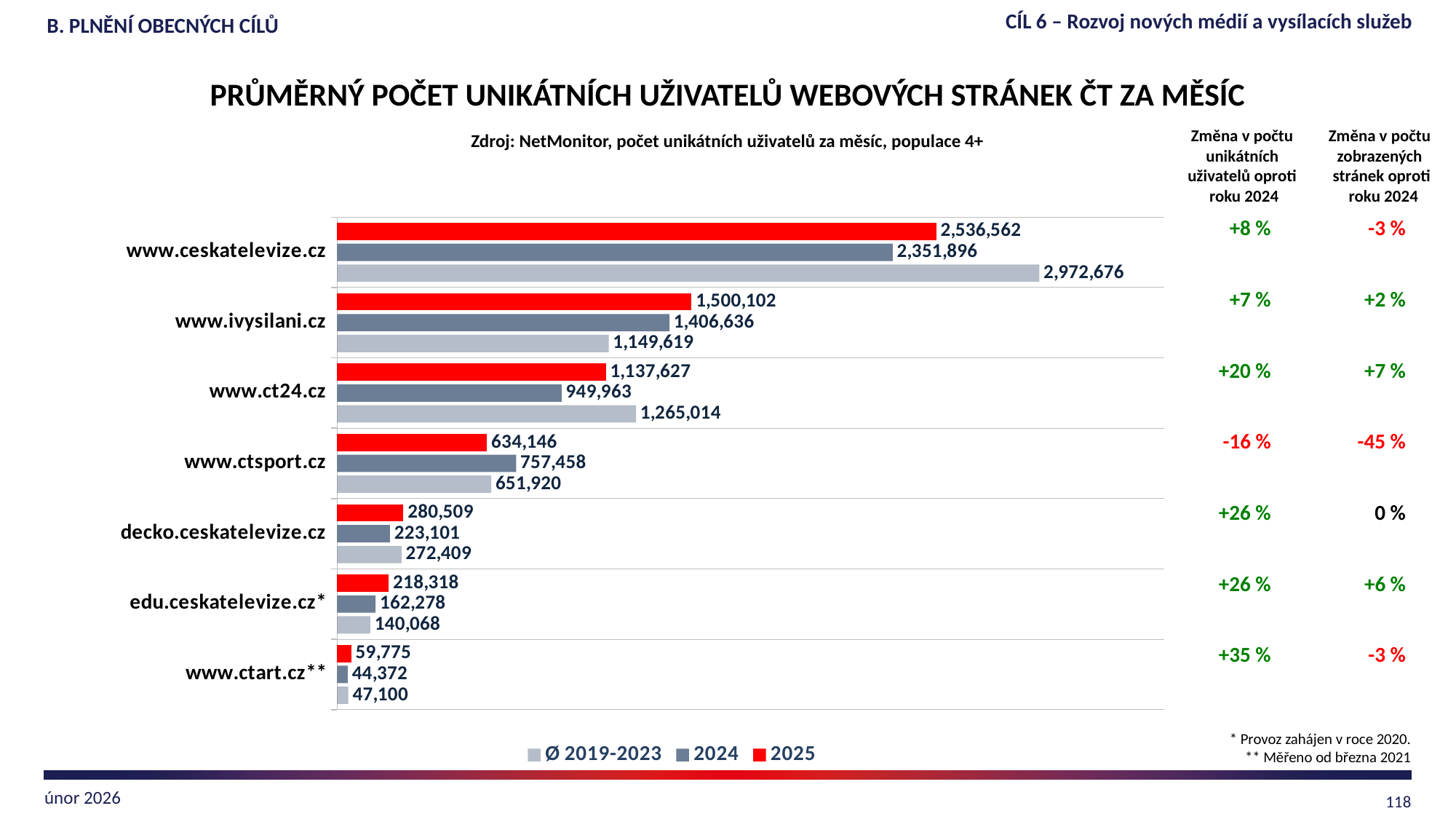
What is the 2024 value for www.ct24.cz? 949,963 What is the difference between the 2025 and 2024 values for decko.ceskatelevize.cz? 57,408 Which website has the lowest 2024 value? www.ctart.cz** What is the Ø 2019-2023 value for edu.ceskatelevize.cz*? 140,068 What is the difference between the 2025 and 2024 values for www.ceskatelevize.cz? 184,666 Which website has the highest 2025 value? www.ceskatelevize.cz What is the 2025 value for www.ivysilani.cz? 1,500,102 For www.ctsport.cz, which is larger: the 2024 value or the 2025 value? 2024 What kind of chart is shown on the slide? Bar chart How many series does the legend list? 3 How many websites are shown in the chart? 7 For www.ct24.cz, which is larger: the Ø 2019-2023 value or the 2025 value? Ø 2019-2023